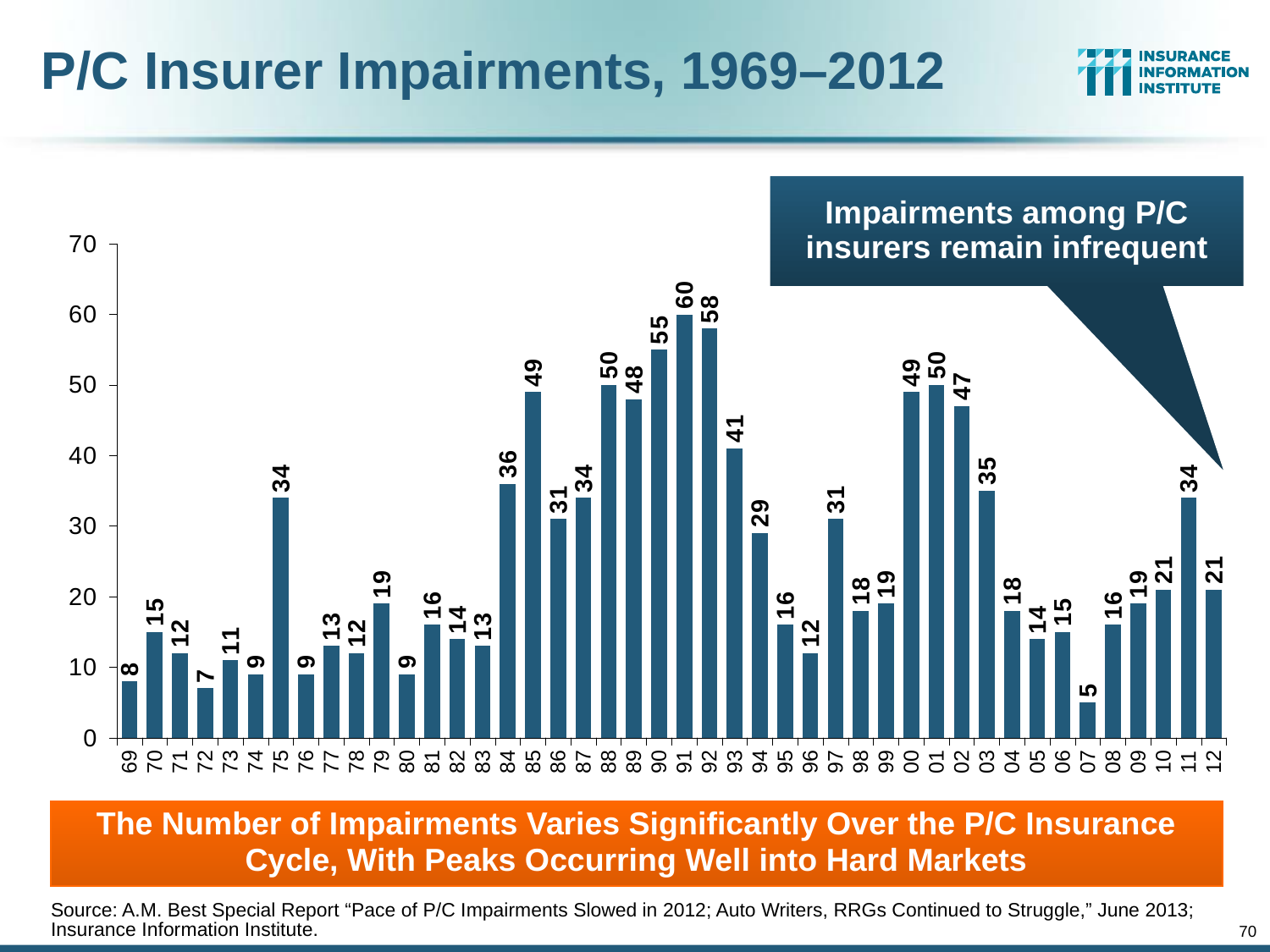
What kind of chart is shown on the slide? Bar chart Which year had more impairments, 1985 or 2002? 1985 What value is shown for 2007? 5 What is the number of P/C insurer impairments shown for 1991? 60 Is the value for 1975 greater or less than 30? greater What is the number of impairments shown for 2012? 21 Which year has the highest number of impairments? 91 Which year has the lowest number of impairments? 07 What is the title of the chart? P/C Insurer Impairments, 1969–2012 Do the values rise or fall from 1984 to 1991? Rise What is the difference between the impairments in 1992 and 1993? 17 How many years are plotted on the chart? 44